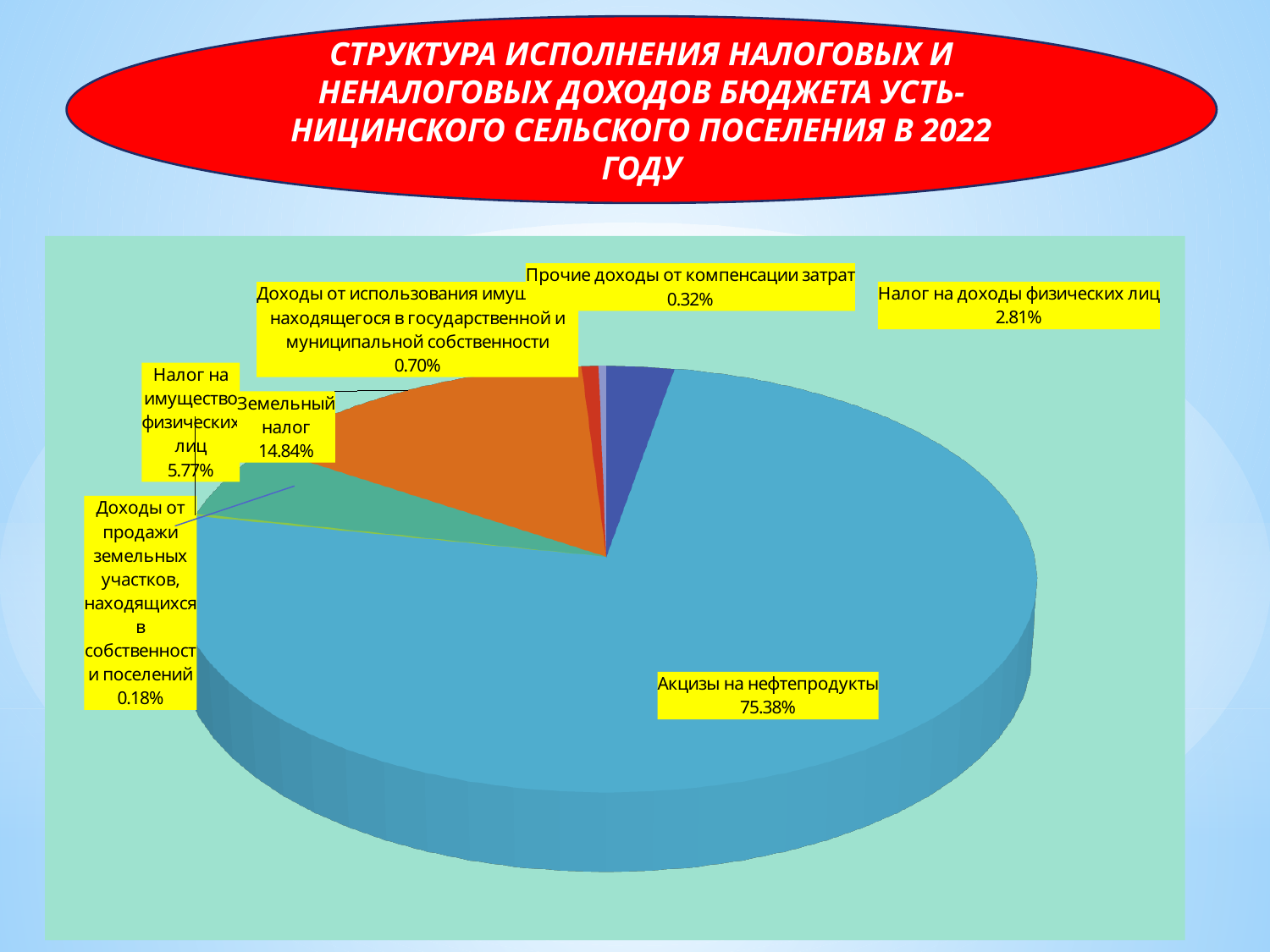
What share is shown for Прочие доходы от компенсации затрат? 0.32% What share of the pie is labelled for Акцизы на нефтепродукты? 75.38% What share is shown for Земельный налог? 14.84% Which category has the smallest slice of the pie? Доходы от продажи земельных участков, находящихся в собственности поселений What is the difference in percentage points between Земельный налог and Налог на имущество физических лиц? 9.07 What kind of chart is shown on the slide? Pie chart What share is shown for Налог на имущество физических лиц? 5.77% What share is shown for Налог на доходы физических лиц? 2.81% Which category has the largest slice of the pie? Акцизы на нефтепродукты What share is shown for Доходы от продажи земельных участков, находящихся в собственности поселений? 0.18% How many categories (slices) are labelled on the pie chart? 7 Which is larger: the share for Налог на доходы физических лиц or the share for Доходы от использования имущества, находящегося в государственной и муниципальной собственности? Налог на доходы физических лиц